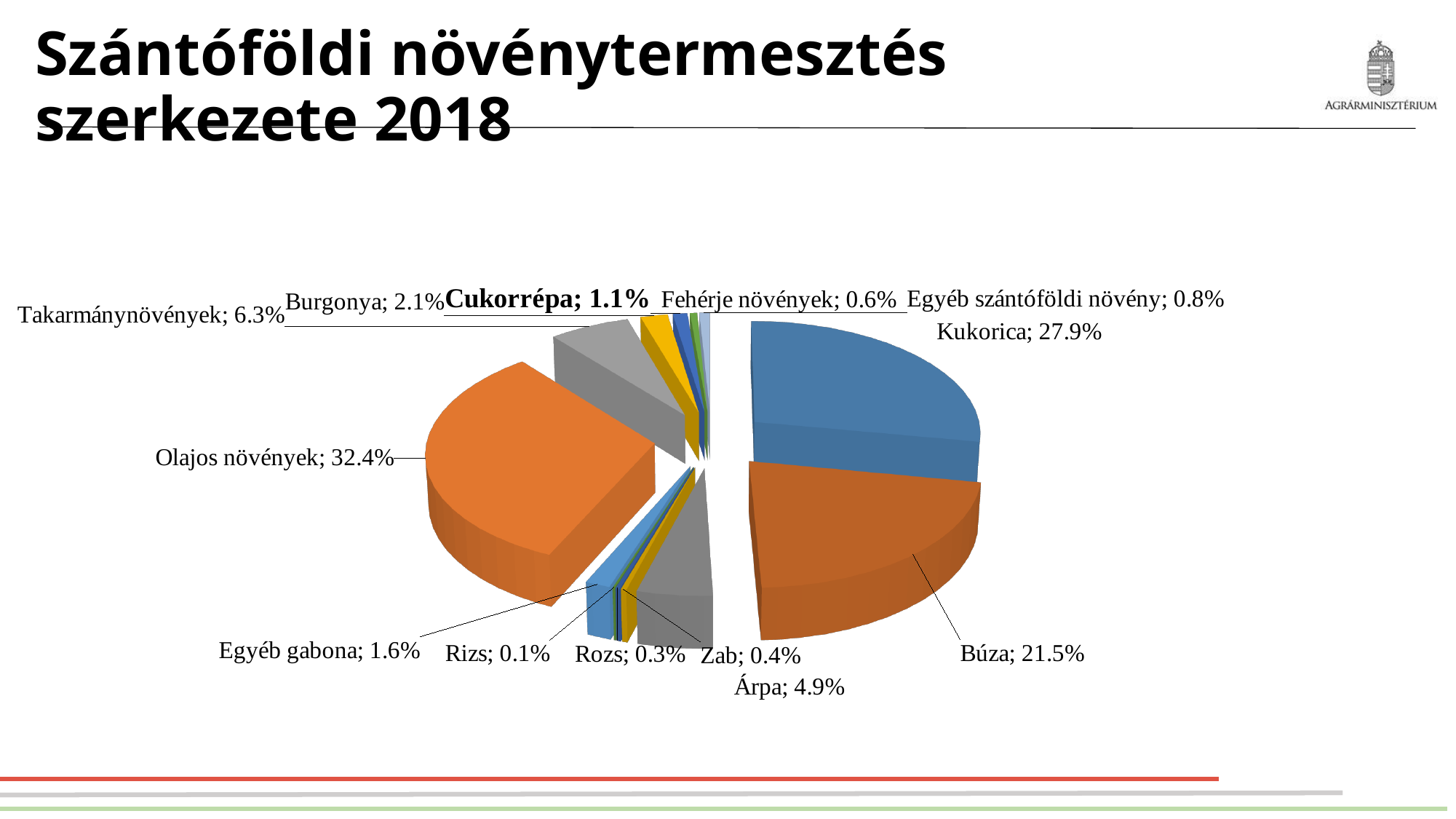
What kind of chart is shown on the slide? pie chart What is the value shown for Takarmánynövények? 6.3% What is the value shown for Cukorrépa? 1.1% Which category has the largest share of the pie? Olajos növények What is the difference between the shares of Kukorica and Búza? 6.4% What is the title of the slide containing the pie chart? Szántóföldi növénytermesztés szerkezete 2018 How many categories are shown in the pie chart? 13 What share does Kukorica have in the pie chart? 27.9% What is the difference between the shares of Olajos növények and Kukorica? 4.5% Which is larger, the share of Árpa or the share of Burgonya? Árpa Which category has the smallest share of the pie? Rizs What share does Búza have in the pie chart? 21.5%